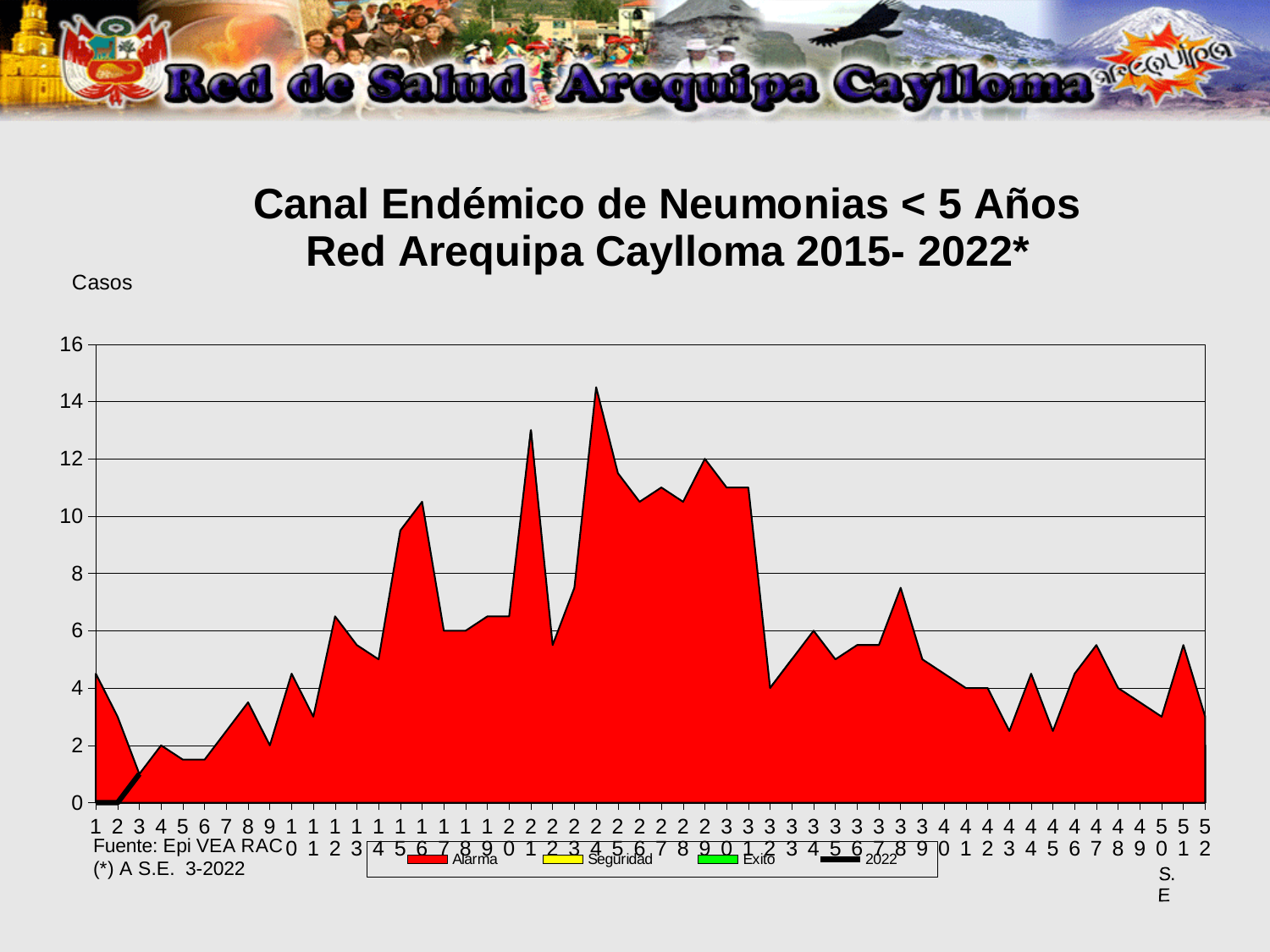
Is the Alarma value at week 32 greater or less than 6? less What colour is the Alarma series in the legend? red Is the Alarma value at week 43 greater or less than 4? less Do the Alarma values rise or fall from week 24 to week 32? fall Is the Alarma value at week 24 greater or less than 12? greater How many epidemiological weeks are shown along the x axis? 52 How many series does the legend list? 4 What is the title of the chart? Canal Endémico de Neumonias < 5 Años Red Arequipa Caylloma 2015- 2022* What kind of chart is shown on the slide? area chart At which week does the Alarma area reach its highest value? 24